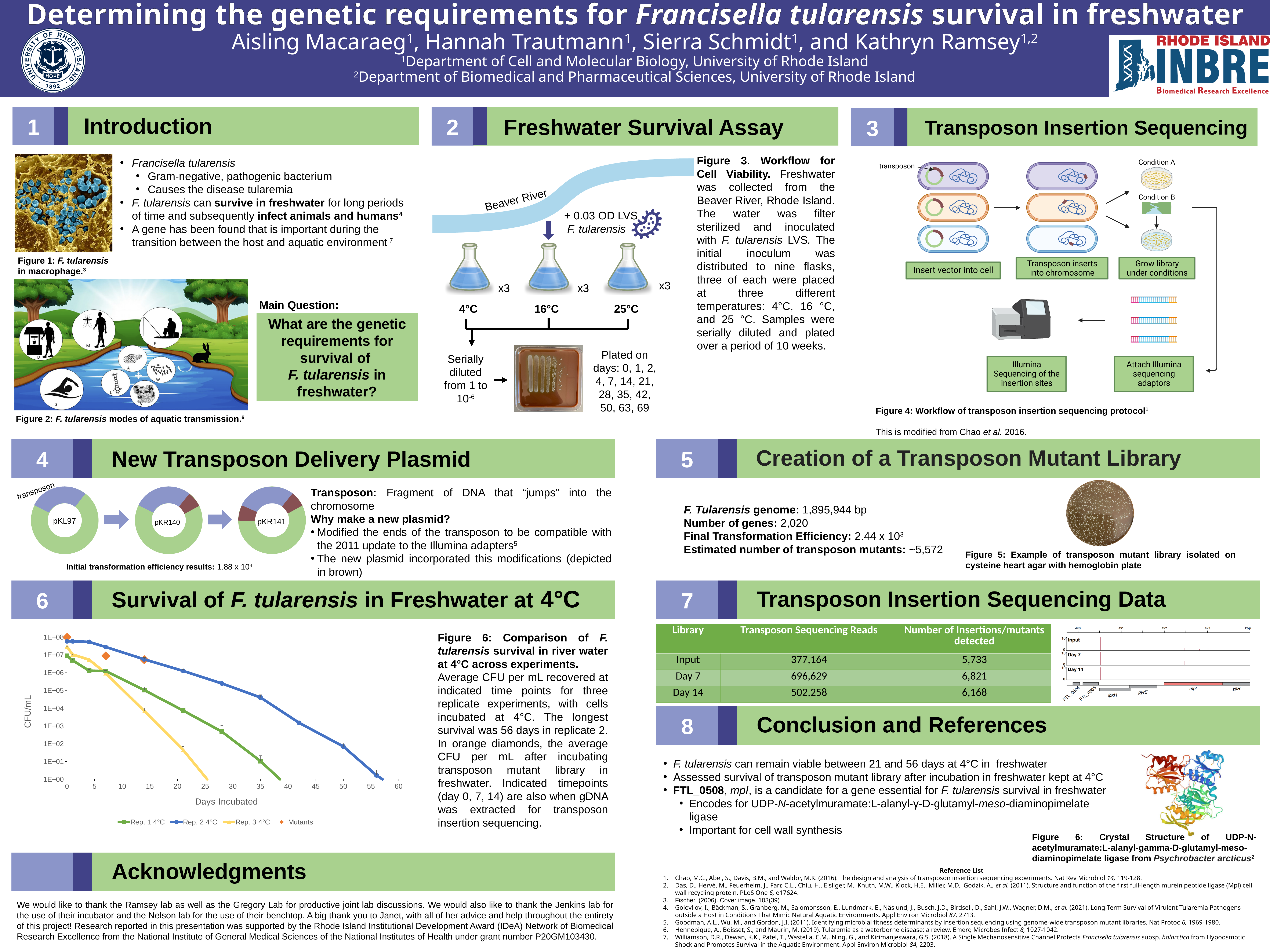
In the Figure 6 chart, is the value for Rep. 2 4°C at day 35 greater or less than 1E+04 CFU/mL? greater What kind of chart is shown in Figure 6 (Survival of F. tularensis in Freshwater at 4°C)? line chart In the Figure 6 chart, is the value for Rep. 1 4°C at day 28 greater or less than 1E+03 CFU/mL? less What is the highest tick value shown on the y-axis of the Figure 6 chart? 1E+08 How many series does the legend of the Figure 6 chart list? 4 What is the label of the y-axis in the Figure 6 chart? CFU/mL What is the label of the x-axis in the Figure 6 chart? Days Incubated How many data points are plotted for the Mutants series in the Figure 6 chart? 3 In the Figure 6 chart, do the CFU/mL values for the replicates rise or fall as the days incubated increase? fall In the Figure 6 chart, is the value for Rep. 2 4°C at day 35 greater or less than 1E+05 CFU/mL? less In the Figure 6 chart, which replicate series reaches 1E+00 CFU/mL at the earliest day? Rep. 3 4°C In the Figure 6 chart, which replicate series reaches 1E+00 CFU/mL at the latest day? Rep. 2 4°C